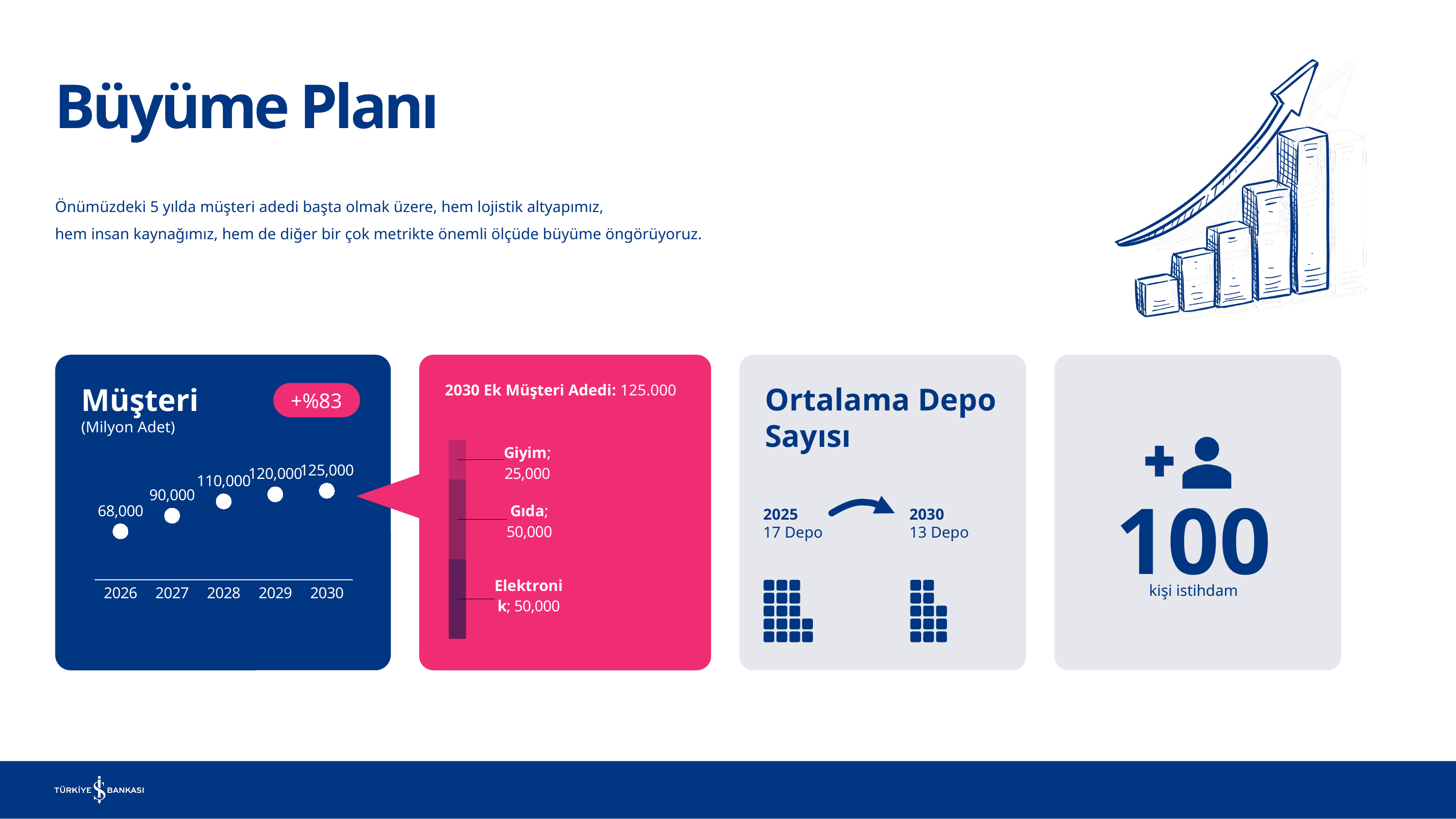
In the Müşteri chart, do the values rise or fall from 2026 to 2030? rise In the Müşteri chart, what is the value for 2030? 125,000 In the Müşteri chart, what is the value for 2026? 68,000 In the Müşteri chart, what is the value for 2028? 110,000 In the Müşteri chart, what is the difference between the 2027 and 2026 values? 22,000 How many years are plotted in the Müşteri chart? 5 In the Müşteri chart, which year has the highest value? 2030 In the stacked bar chart in the pink panel, which segment is the smallest? Giyim In the stacked bar chart in the pink panel, what is the total of the stacked bar? 125,000 In the stacked bar chart in the pink panel, what is the value for Giyim? 25,000 In the Müşteri chart, which year has the lowest value? 2026 In the stacked bar chart in the pink panel, what is the value for Gıda? 50,000